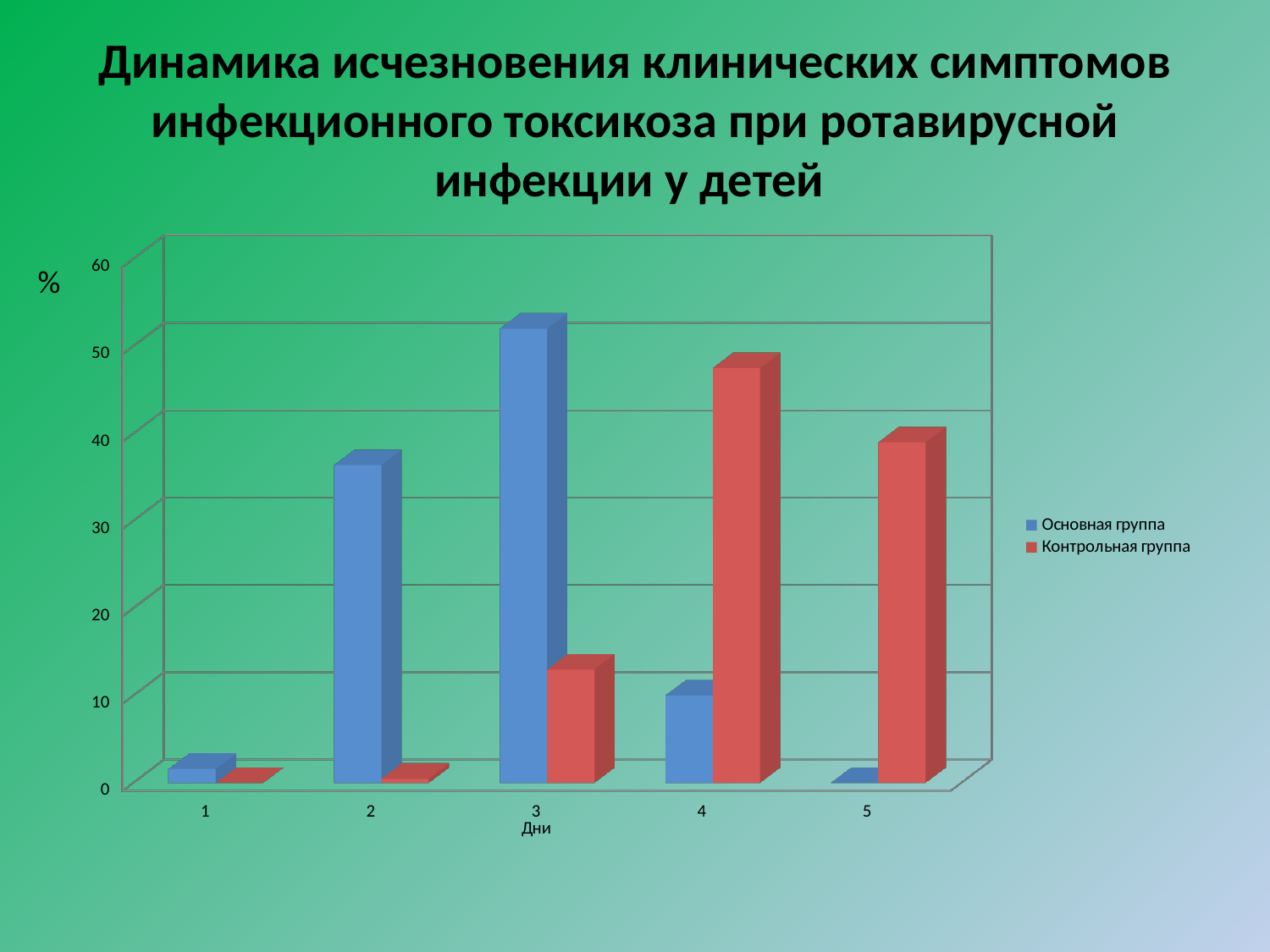
What is the label of the x axis? Дни On which day is the value for Основная группа highest? 3 How many series does the legend list? 2 Is the value for Основная группа on day 2 greater or less than 30? greater On day 4, which series has the larger value, Основная группа or Контрольная группа? Контрольная группа Is the value for Контрольная группа on day 3 greater or less than 20? less How many day categories are shown on the x axis? 5 On which day is the value for Контрольная группа highest? 4 Is the value for Основная группа on day 3 greater or less than 50? greater What kind of chart is shown on the slide? bar chart On day 2, which series has the larger value, Основная группа or Контрольная группа? Основная группа